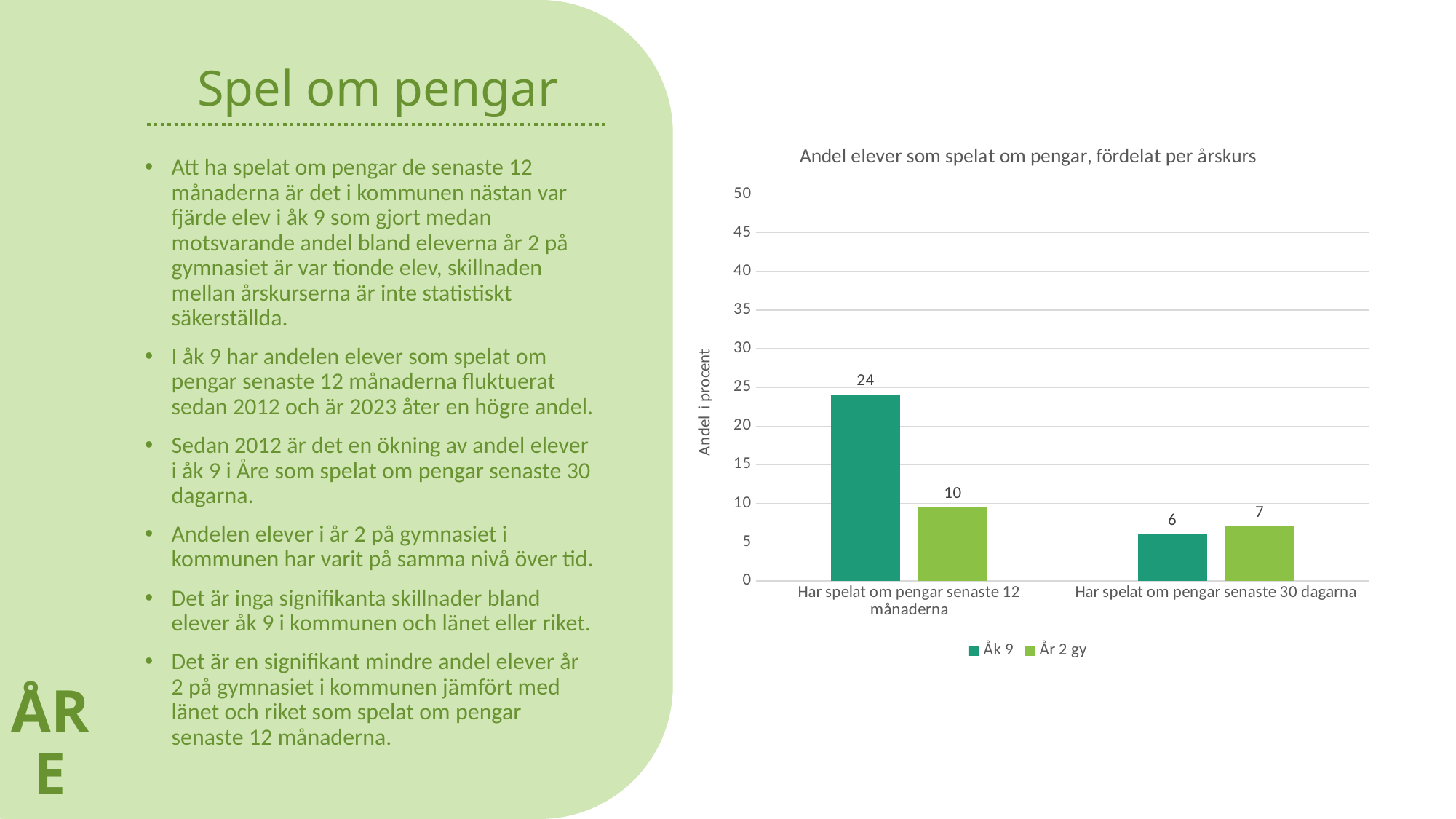
What is the value for År 2 gy in the category 'Har spelat om pengar senaste 12 månaderna'? 10 What kind of chart is shown on the slide? Bar chart How many categories are shown on the x axis? 2 How many series does the legend list? 2 What is the value for Åk 9 in the category 'Har spelat om pengar senaste 12 månaderna'? 24 What is the title of the chart? Andel elever som spelat om pengar, fördelat per årskurs Which bar has the lowest value in the chart? Åk 9, Har spelat om pengar senaste 30 dagarna In the category 'Har spelat om pengar senaste 30 dagarna', which series has the larger value, Åk 9 or År 2 gy? År 2 gy What is the value for Åk 9 in the category 'Har spelat om pengar senaste 30 dagarna'? 6 What is the value for År 2 gy in the category 'Har spelat om pengar senaste 30 dagarna'? 7 Which series has the highest value in the chart? Åk 9 What is the difference between Åk 9 and År 2 gy in the category 'Har spelat om pengar senaste 12 månaderna'? 14